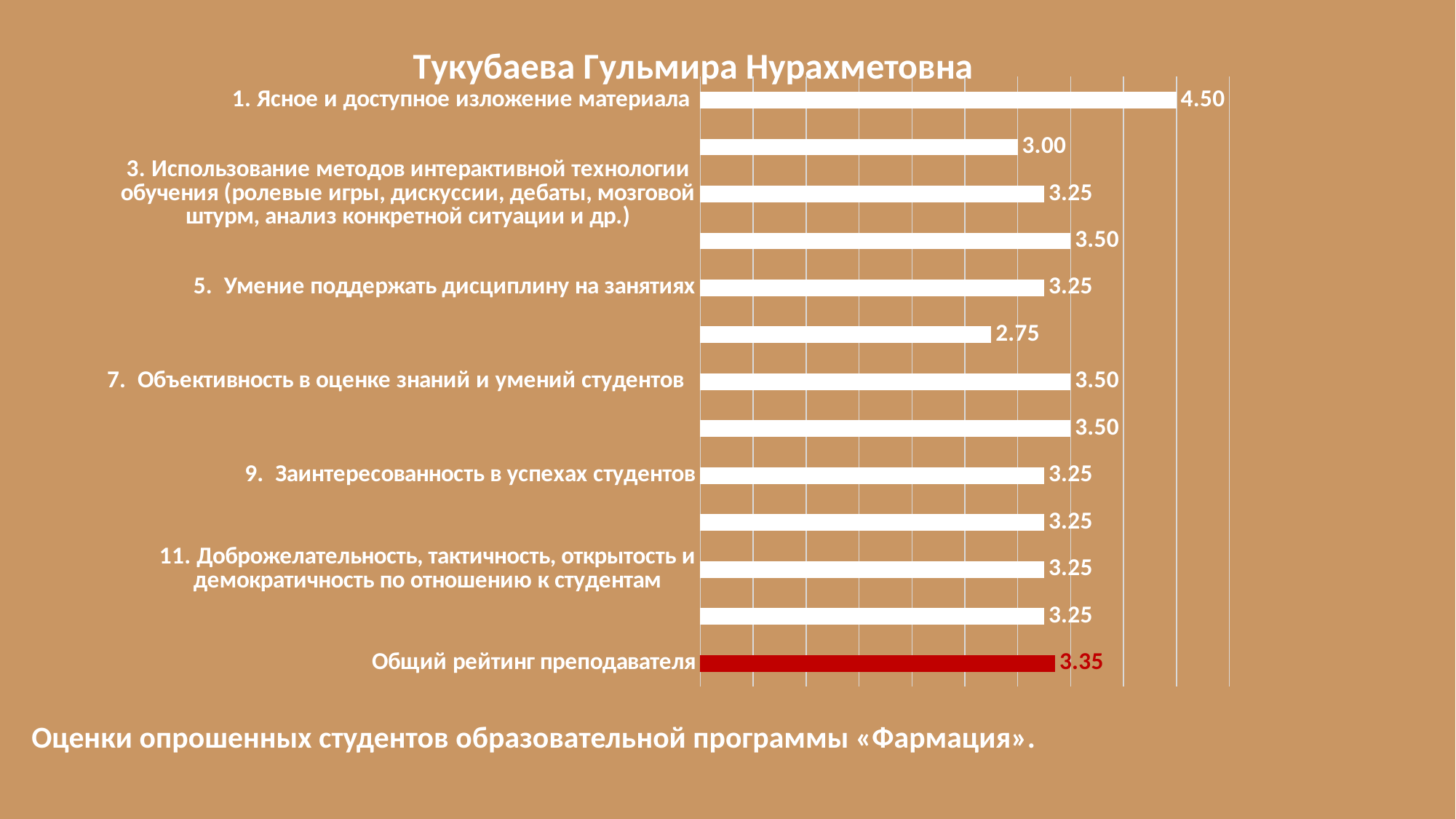
What is the value for "5. Умение поддержать дисциплину на занятиях"? 3.25 What is the value for "Общий рейтинг преподавателя"? 3.35 What colour is the bar for "Общий рейтинг преподавателя"? Red What is the value for "7. Объективность в оценке знаний и умений студентов"? 3.50 How many bars are plotted in the chart? 13 What is the smallest value labeled on any bar in the chart? 2.75 What kind of chart is shown on the slide? Bar chart What is the difference between the value for "1. Ясное и доступное изложение материала" and "Общий рейтинг преподавателя"? 1.15 Which is larger: the value for "7. Объективность в оценке знаний и умений студентов" or for "5. Умение поддержать дисциплину на занятиях"? 7. Объективность в оценке знаний и умений студентов What is the value for "1. Ясное и доступное изложение материала"? 4.50 What is the difference between the values for "7. Объективность в оценке знаний и умений студентов" and "9. Заинтересованность в успехах студентов"? 0.25 Which category has the highest value? 1. Ясное и доступное изложение материала